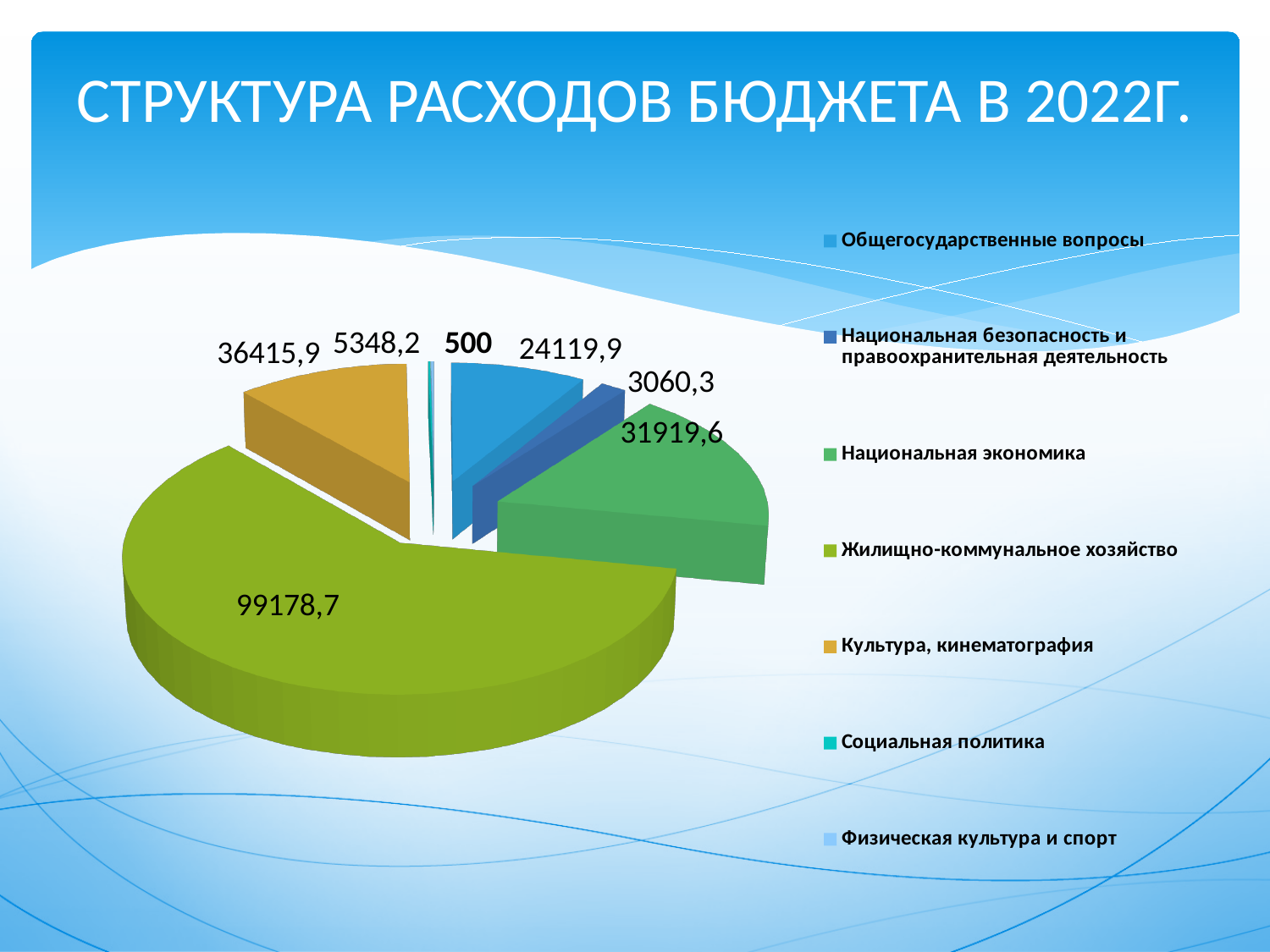
What is the difference between the values for Жилищно-коммунальное хозяйство and Культура, кинематография? 62762,8 What is the value for Национальная экономика? 31919,6 What is the title of the slide containing the chart? СТРУКТУРА РАСХОДОВ БЮДЖЕТА В 2022Г. What is the value for Жилищно-коммунальное хозяйство? 99178,7 What type of chart is shown on the slide? Pie chart Which category has the largest slice of the pie? Жилищно-коммунальное хозяйство What is the value for Общегосударственные вопросы? 24119,9 What is the value for Физическая культура и спорт? 500 What is the value for Культура, кинематография? 36415,9 Which is larger: Национальная экономика or Общегосударственные вопросы? Национальная экономика How many categories does the legend list? 7